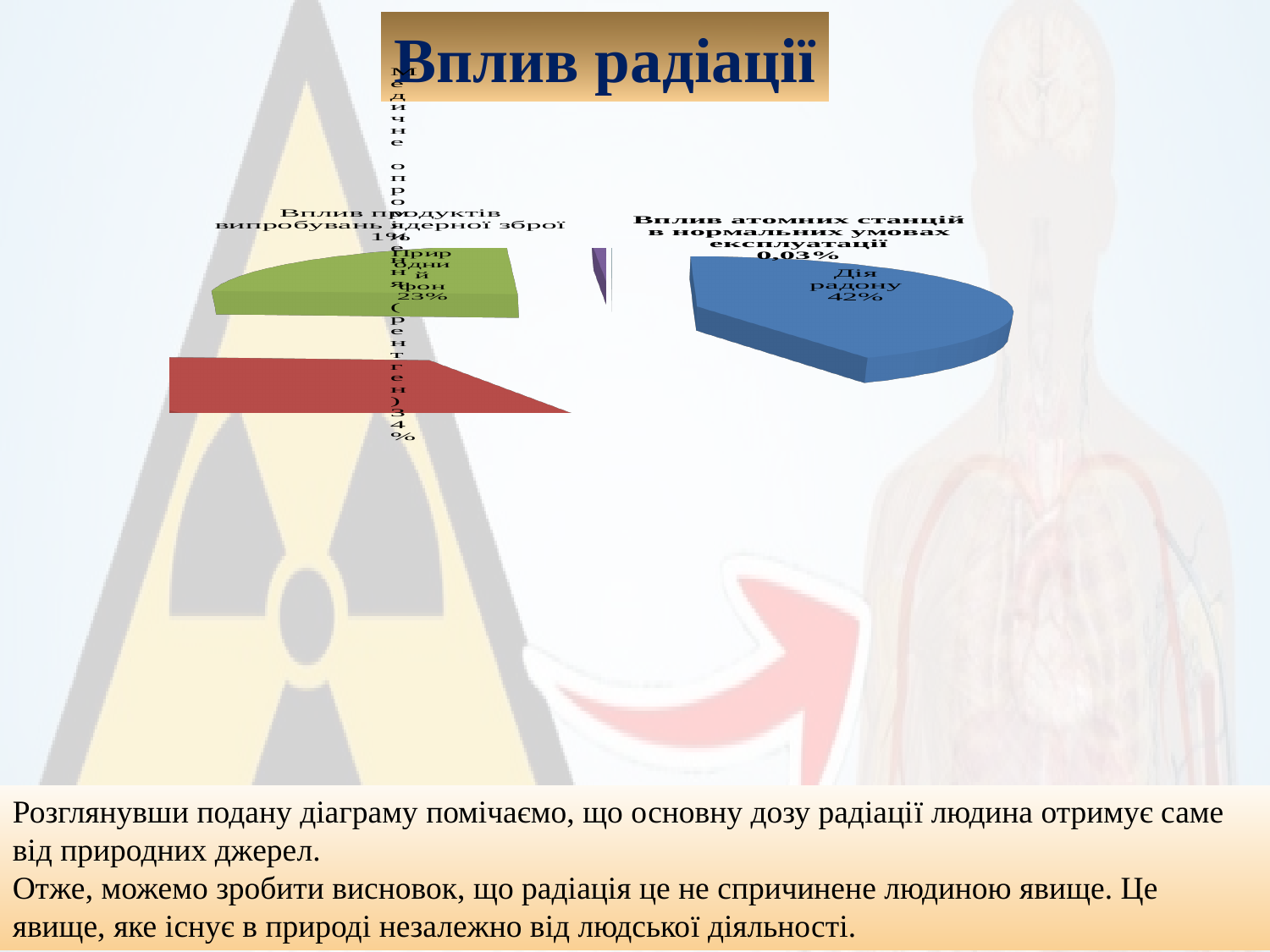
What share of the pie is labelled "Дія радону"? 42% What value is shown for "Вплив продуктів випробувань ядерної зброї"? 1% Which category has the largest share of the pie? Дія радону Which category has the smallest share of the pie? Вплив атомних станцій в нормальних умовах експлуатації What value is shown for "Вплив атомних станцій в нормальних умовах експлуатації"? 0,03% What value is shown for "Природний фон"? 23% By how many percentage points does "Дія радону" exceed "Природний фон"? 19 percentage points Which is larger: the share for "Медичне опромінення (рентген)" or for "Природний фон"? Медичне опромінення (рентген) What value is shown for "Медичне опромінення (рентген)"? 34% What kind of chart is shown on the slide? pie chart What colour is the slice for "Дія радону"? blue How many categories are labelled in the pie chart? 5